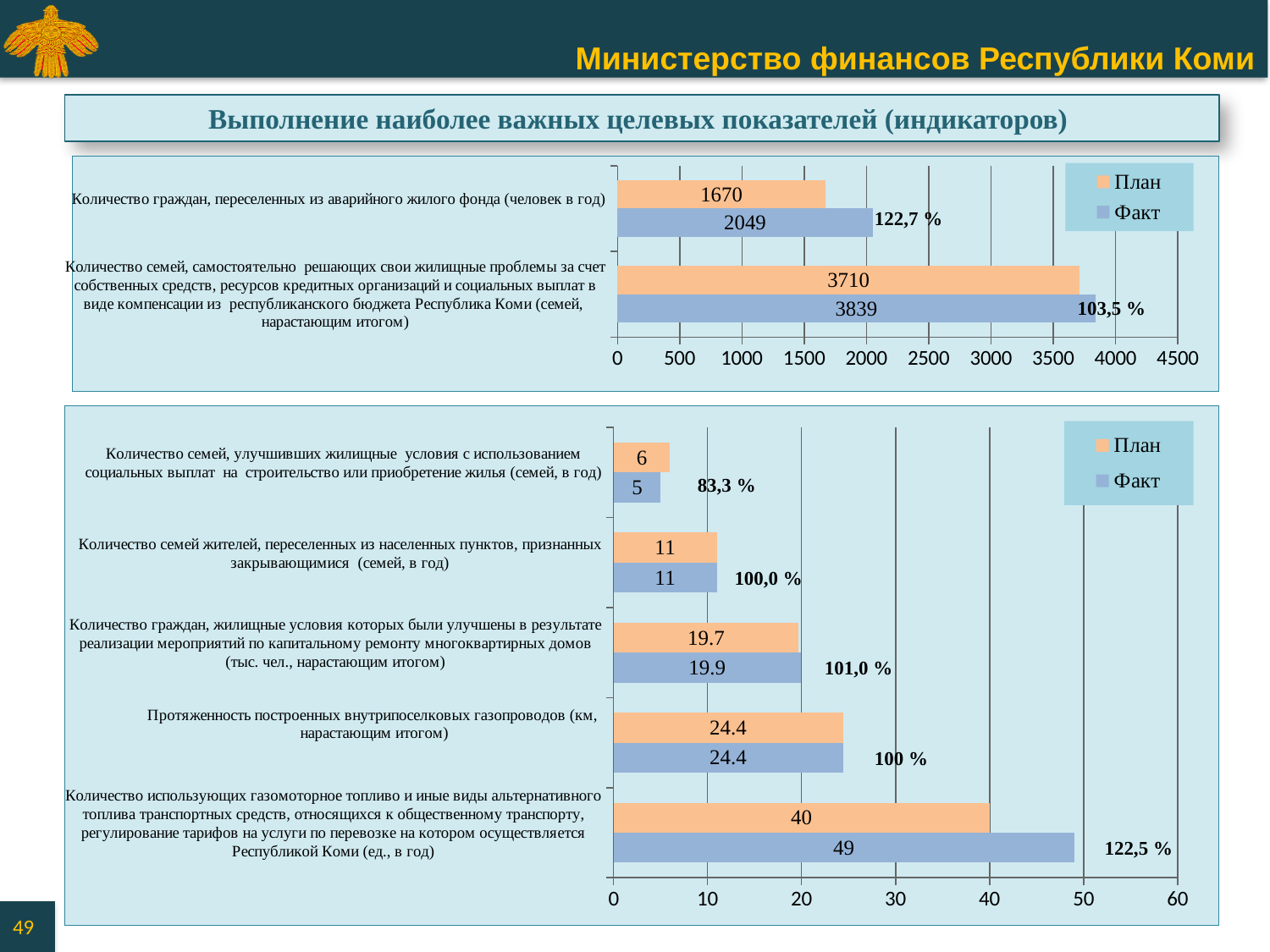
In the bottom chart, what is the Факт value for the number of vehicles using gas-motor fuel and other alternative fuels (ед., в год)? 49 In the top chart, what is the difference between the Факт and План values for the number of families solving their housing problems independently (3839 vs 3710)? 129 In the top chart, what is the Факт (actual) value for the number of citizens resettled from emergency housing? 2049 In the top chart, what percentage is shown next to the bars for the number of citizens resettled from emergency housing? 122,7 % In the bottom chart, is the План value or the Факт value larger for the number of families that improved housing conditions using social payments? План How many series does the legend of the top chart list? 2 In the bottom chart, which category has the lowest План value? Количество семей, улучшивших жилищные условия с использованием социальных выплат на строительство или приобретение жилья In the bottom chart, what is the Факт value for the number of citizens whose housing conditions were improved through capital repairs of apartment buildings (тыс. чел.)? 19.9 What type of chart is the bottom chart? Bar chart How many categories are shown in the bottom chart? 5 In the bottom chart, which category has the highest Факт value? Количество использующих газомоторное топливо и иные виды альтернативного топлива транспортных средств In the top chart, what is the План (plan) value for the number of citizens resettled from emergency housing (человек в год)? 1670